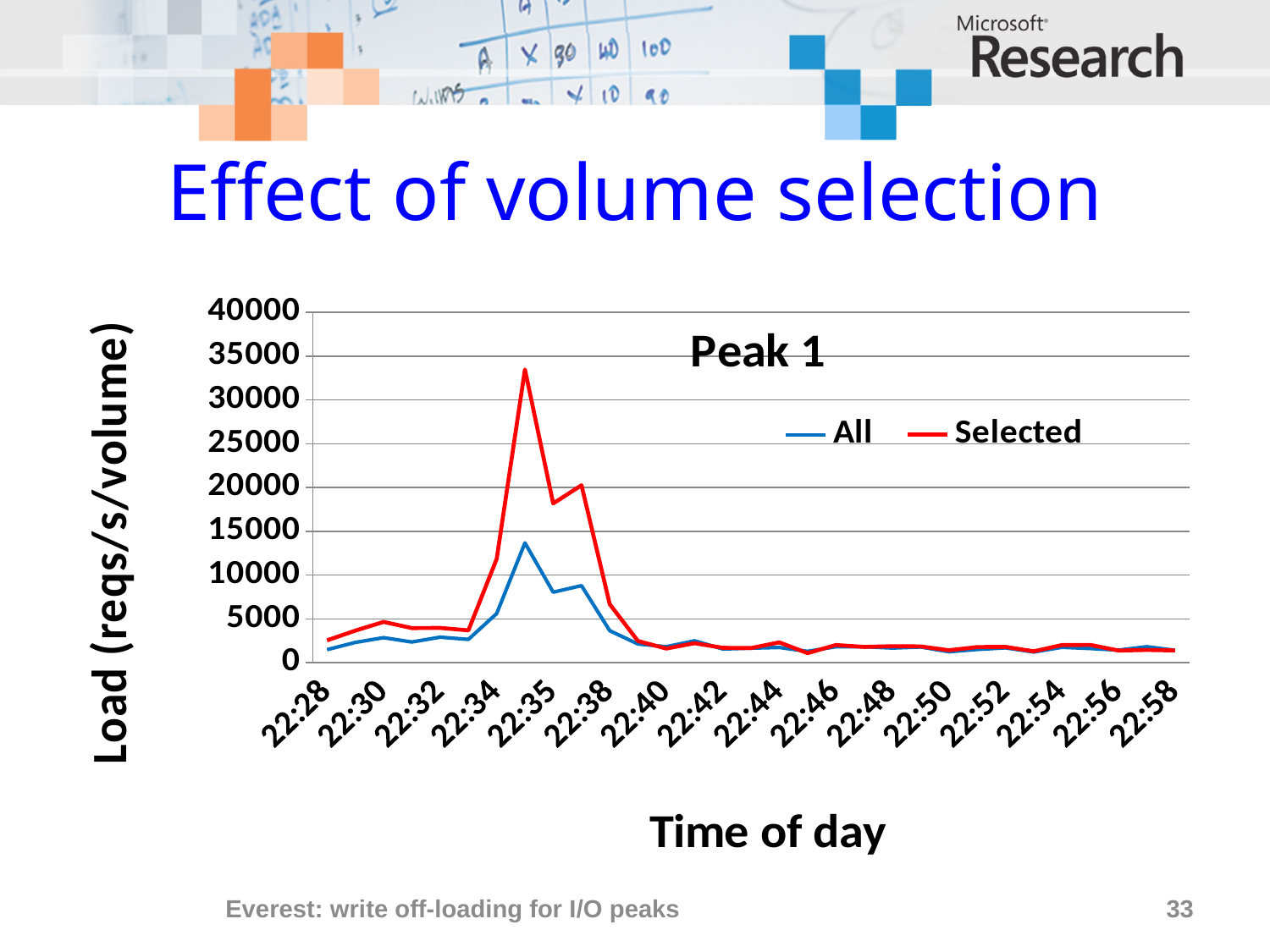
Is the value of the Selected series at 22:28 greater or less than 5000? less Is the peak value of the Selected series greater or less than 30000? greater Is the peak value of the All series greater or less than 15000? less How many series does the chart's legend list? 2 Do the values of the Selected series rise or fall between 22:38 and 22:40? fall Which series reaches the higher peak value? Selected What is the title printed inside the chart area? Peak 1 What are the two series named in the legend? All and Selected How many time labels are shown on the x axis? 16 What kind of chart is shown on the slide? line chart